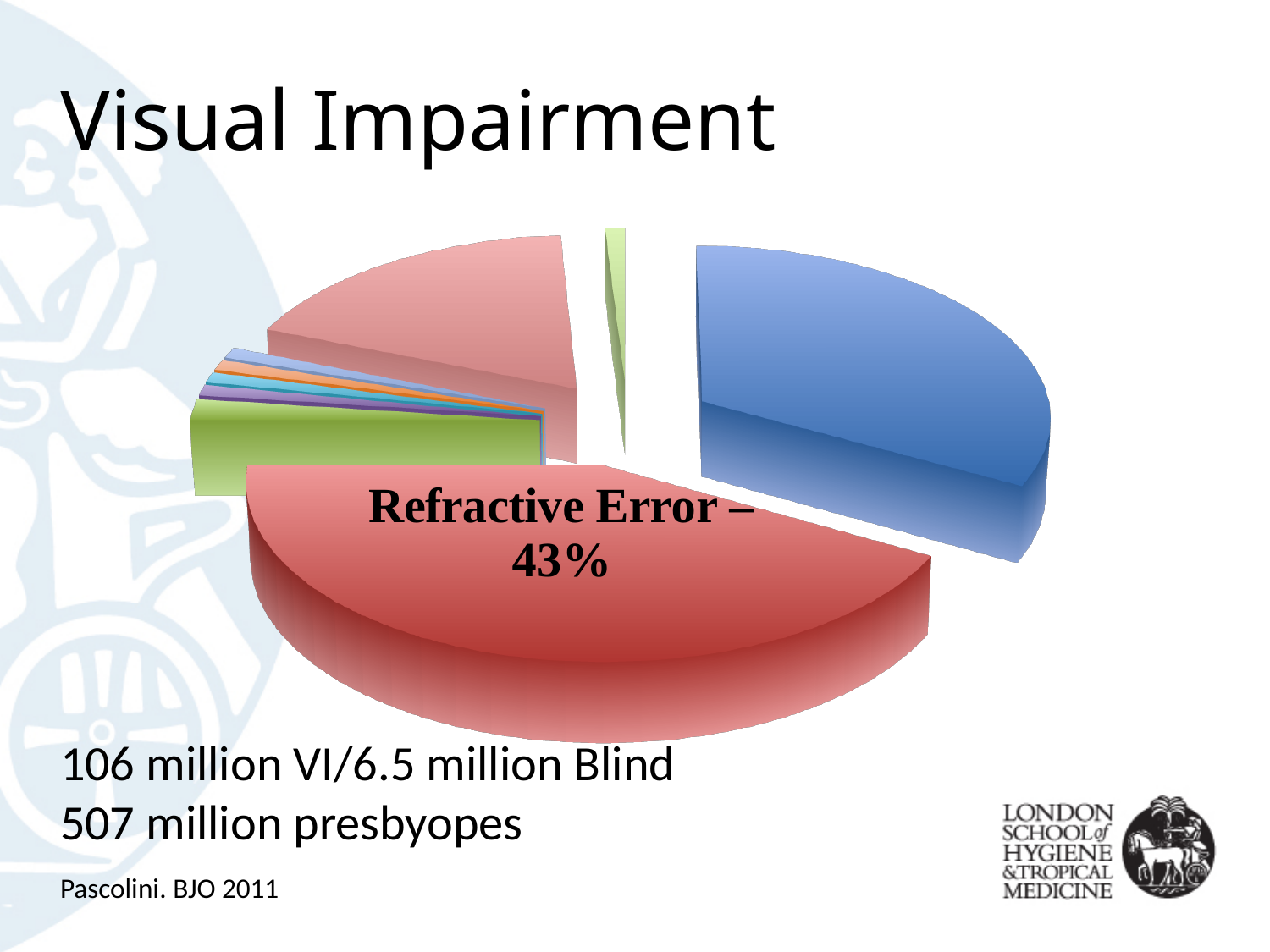
What is the title of the slide containing the pie chart? Visual Impairment Is the share for Refractive Error greater or less than 50%? less What kind of chart is shown on the slide? pie chart Which labelled slice is the largest in the pie chart? Refractive Error What colour is the Refractive Error slice? red What percentage is printed on the Refractive Error slice? 43% What share of the pie does the Refractive Error slice represent? 43%